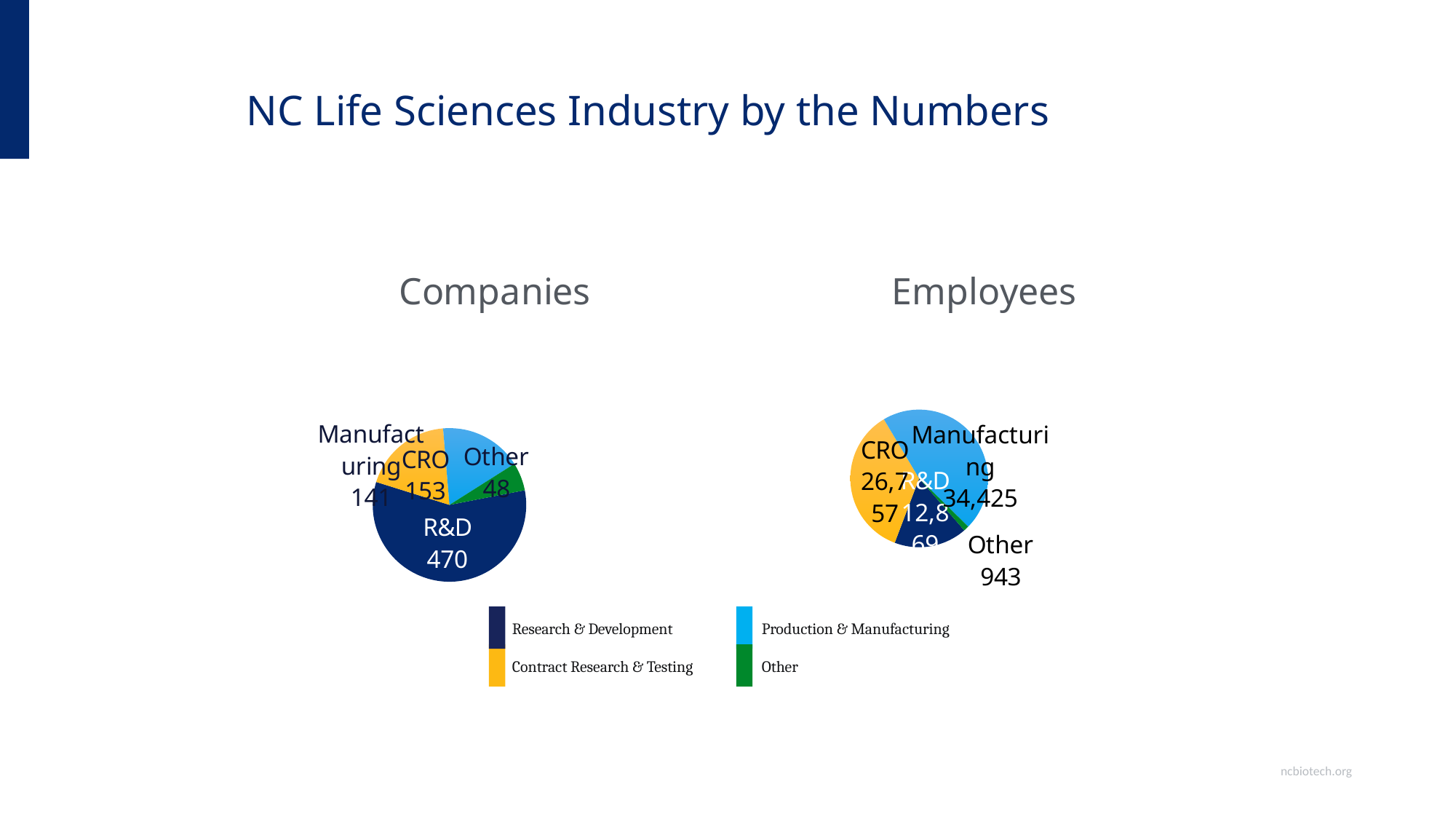
In the Companies pie chart, what is the difference between the R&D and CRO values? 317 In the Companies pie chart, which category has the largest slice? R&D In the Employees pie chart, which category has the largest slice? Manufacturing In the Employees pie chart, what is the value for Manufacturing? 34,425 In the Companies pie chart, what is the value for Other? 48 In the Employees pie chart, what is the value for Other? 943 In the Companies pie chart, how many companies are in R&D? 470 In the Companies pie chart, which is larger, CRO or Manufacturing? CRO In the Companies pie chart, what is the value for Manufacturing? 141 What type of chart is used for the Companies and Employees data? Pie chart In the Companies pie chart, what is the value for CRO? 153 In the Companies pie chart, which category has the smallest slice? Other